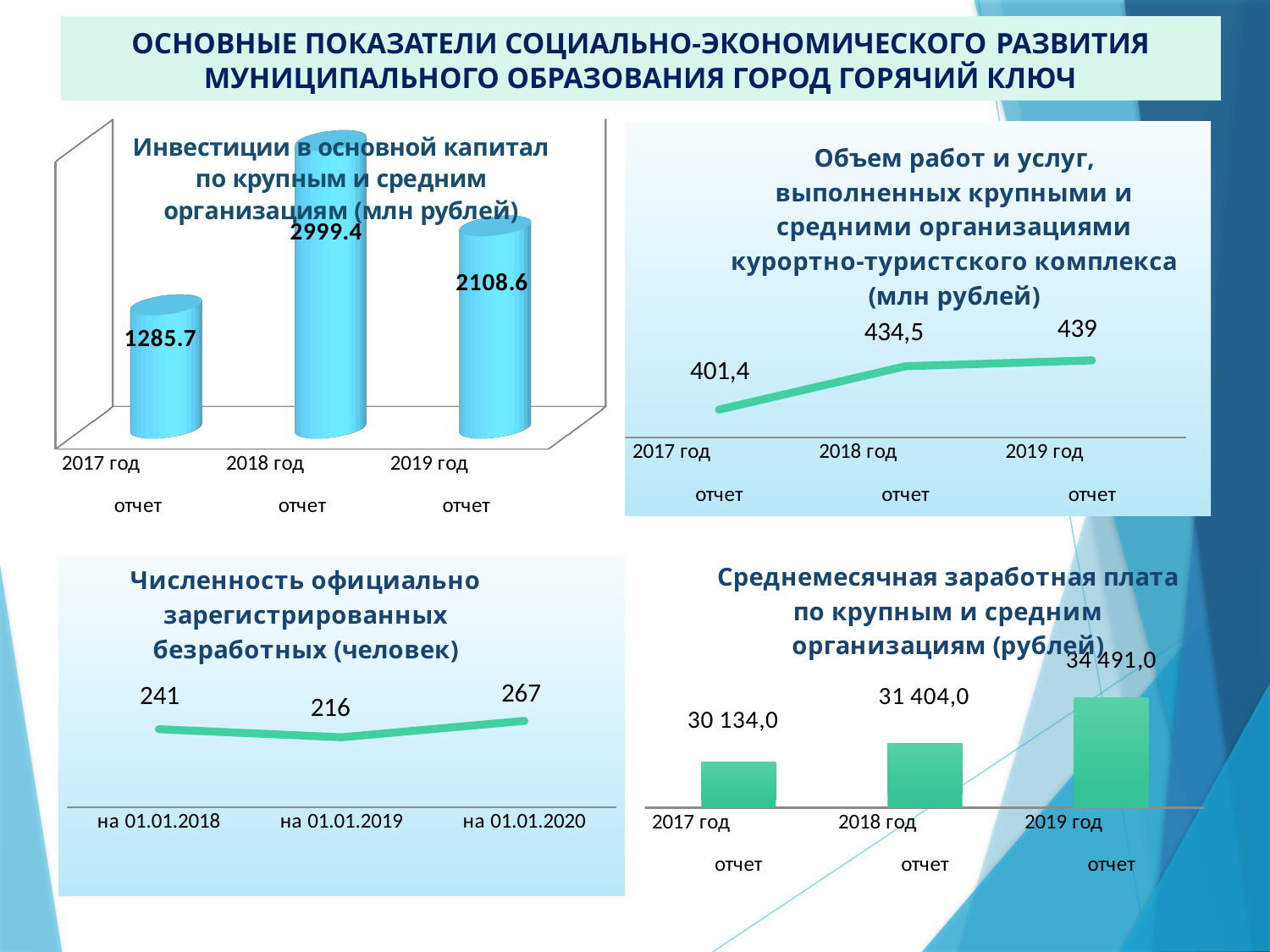
In the bottom-left chart (Численность официально зарегистрированных безработных), what is the value на 01.01.2019? 216 In the top-right chart (Объем работ и услуг курортно-туристского комплекса), do the values rise or fall from 2017 to 2019? rise In the top-left chart (Инвестиции в основной капитал), what is the value for 2018 год отчет? 2999.4 In the bottom-right chart (Среднемесячная заработная плата), which is larger, the value for 2017 год or 2018 год? 2018 год In the bottom-left chart (Численность официально зарегистрированных безработных), what is the difference between the values на 01.01.2020 and на 01.01.2018? 26 How many data points are plotted in the bottom-left chart (Численность официально зарегистрированных безработных)? 3 In the top-right chart (Объем работ и услуг курортно-туристского комплекса), what is the value for 2017 год отчет? 401,4 In the top-left chart (Инвестиции в основной капитал), what is the difference between the 2018 and 2019 values? 890.8 In the top-right chart (Объем работ и услуг курортно-туристского комплекса), which year has the highest value? 2019 год What kind of chart is the top-left chart (Инвестиции в основной капитал)? bar chart In the bottom-right chart (Среднемесячная заработная плата), what is the value for 2019 год отчет? 34 491,0 In the top-left chart (Инвестиции в основной капитал), which year has the lowest value? 2017 год